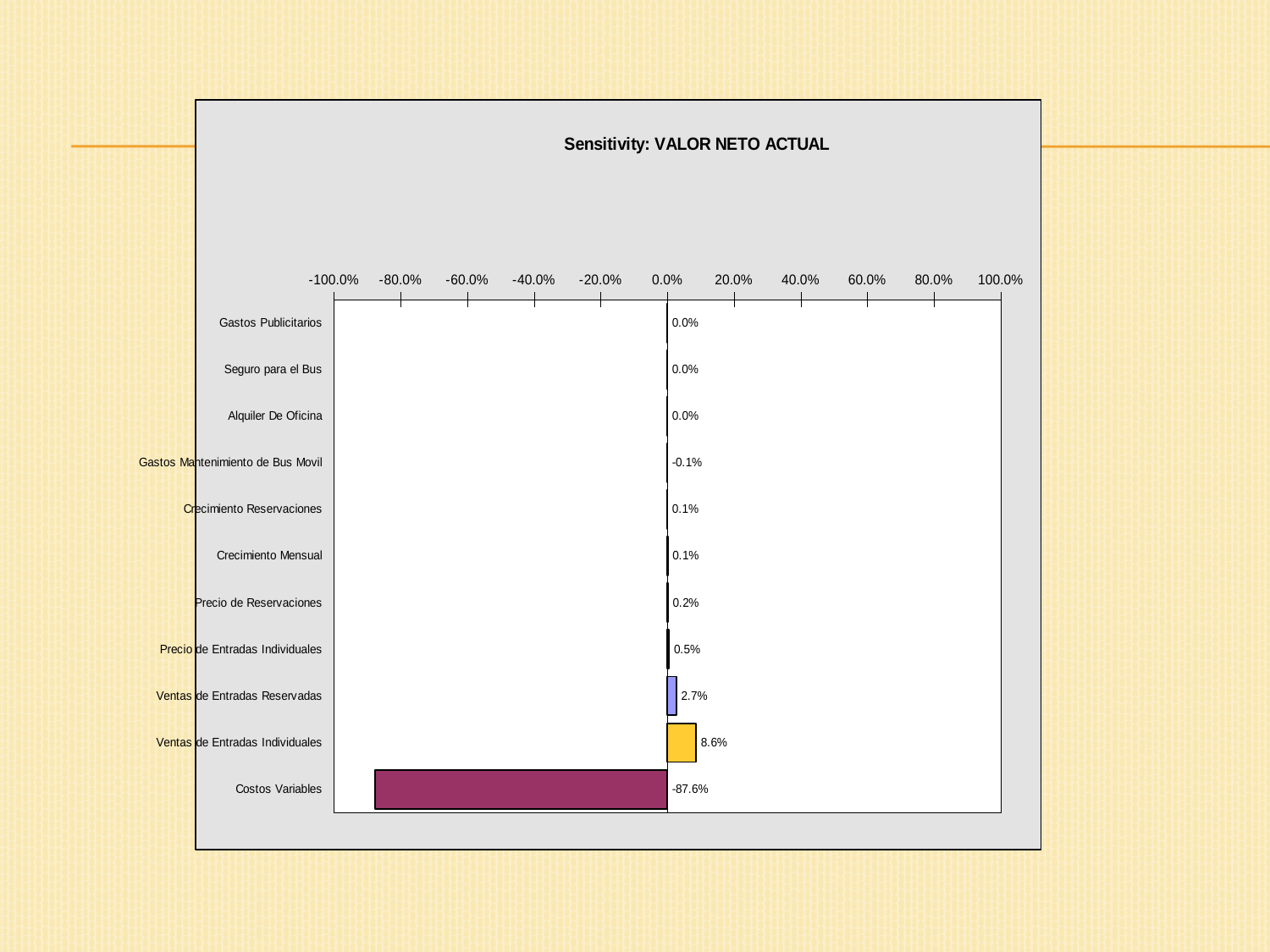
What is the value for Costos Variables? -87.6% What is the value for Ventas de Entradas Individuales? 8.6% Which is larger, the value for Precio de Reservaciones or the value for Precio de Entradas Individuales? Precio de Entradas Individuales What is the value for Ventas de Entradas Reservadas? 2.7% What is the difference between the values for Ventas de Entradas Individuales and Ventas de Entradas Reservadas? 5.9% How many categories are shown on the chart? 11 Which category has the highest value? Ventas de Entradas Individuales What is the value for Precio de Entradas Individuales? 0.5% What is the value for Gastos Mantenimiento de Bus Movil? -0.1% What is the title of the chart? Sensitivity: VALOR NETO ACTUAL Which category has the lowest value? Costos Variables Is the value for Costos Variables greater or less than -80.0%? less